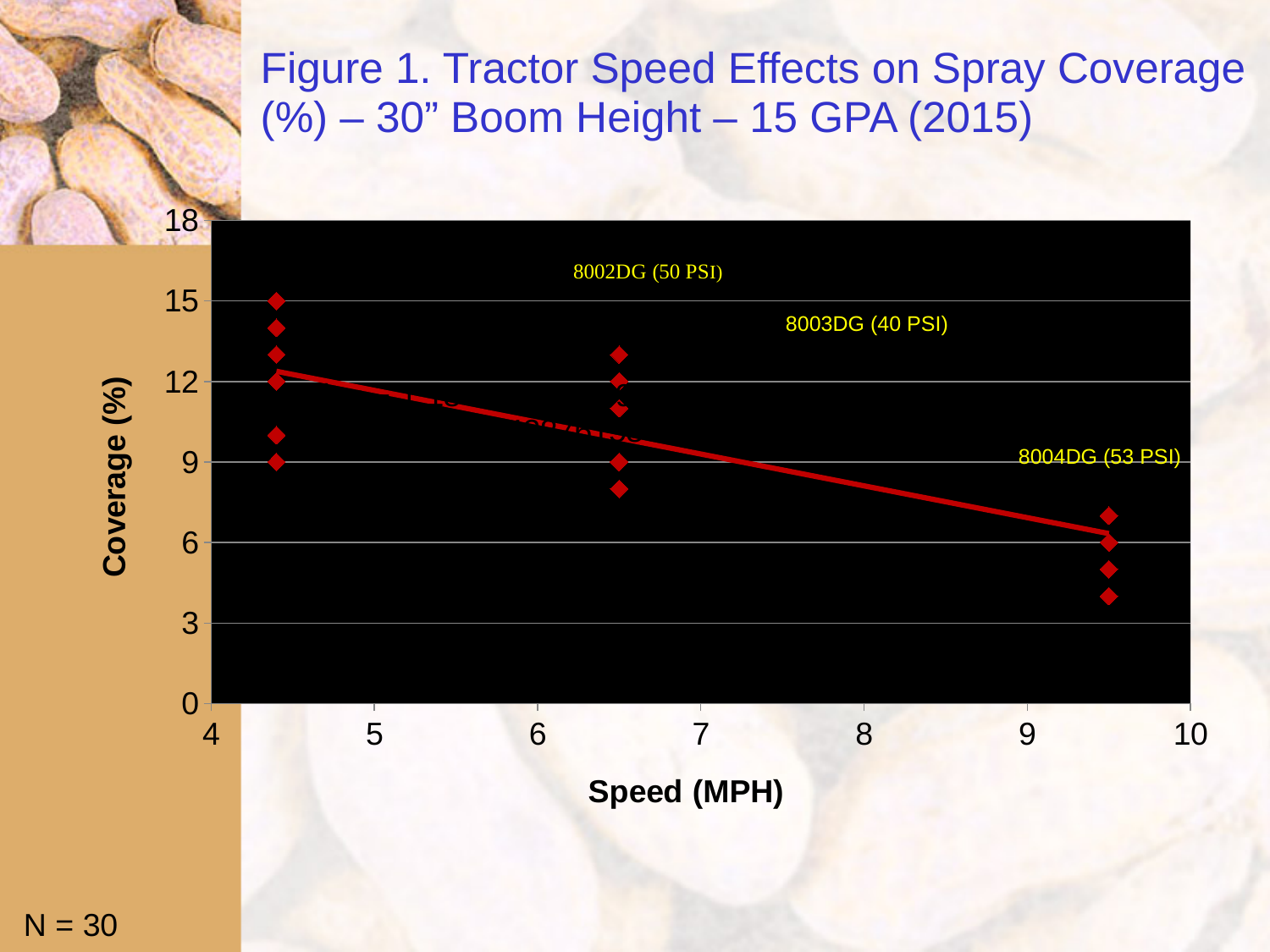
What kind of chart is shown on the slide? scatter chart Which nozzle group has the lowest plotted coverage value? 8004DG (53 PSI) Which speed group has higher coverage values overall, the one at about 4.5 MPH or the one at about 9.5 MPH? about 4.5 MPH Which nozzle label is shown next to the points at about 9.5 MPH? 8004DG (53 PSI) Is the highest coverage value plotted at about 6.5 MPH greater or less than 12? greater Is the lowest coverage value plotted at about 6.5 MPH greater or less than 9? less What is the title of the x axis of the chart? Speed (MPH) Is the highest coverage value plotted at about 4.5 MPH greater or less than 12? greater As tractor speed increases along the x axis, does spray coverage rise or fall? fall How many distinct speed groups (clusters of points) are plotted on the chart? 3